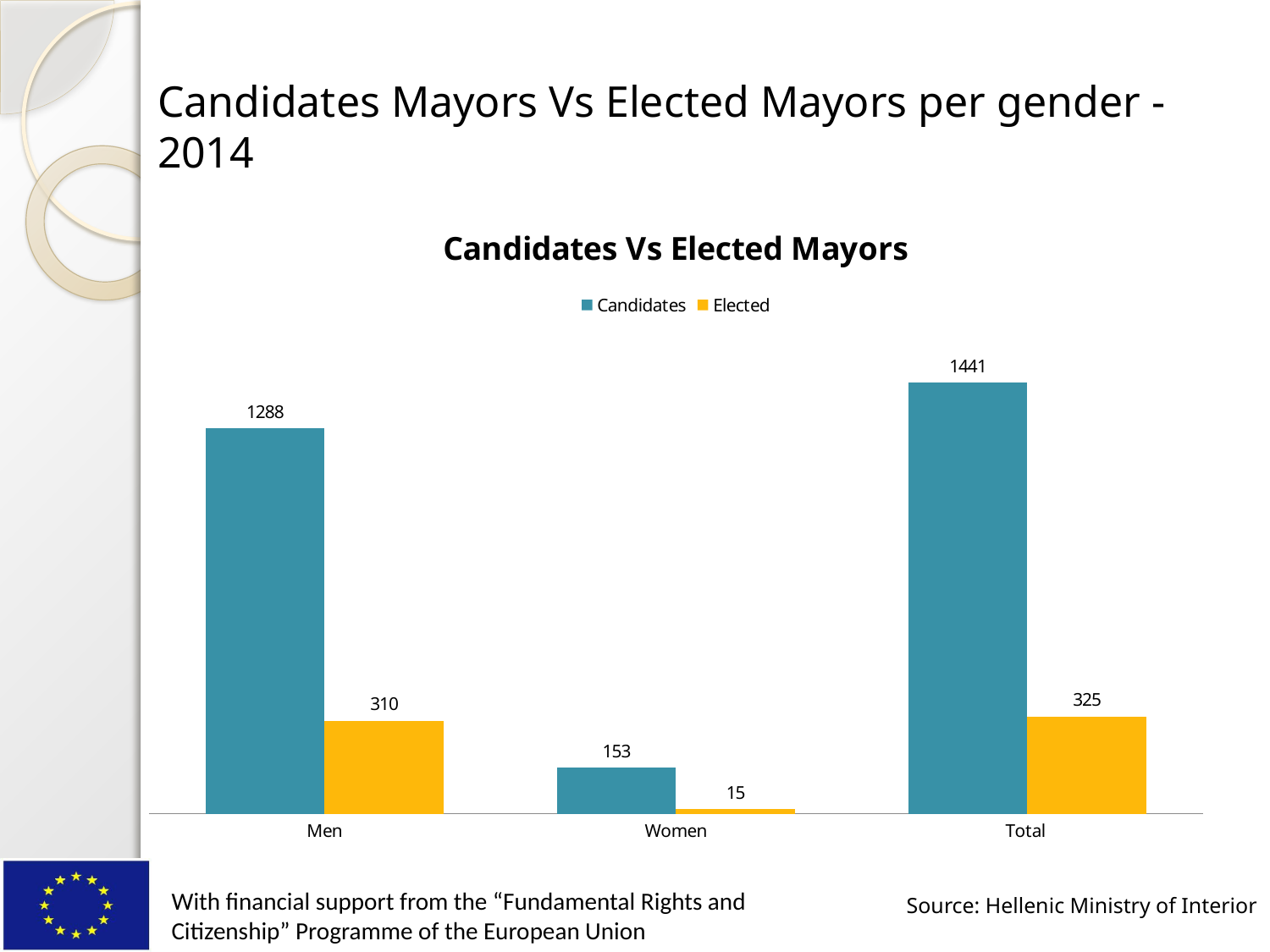
Which category has the highest Elected value? Total How many categories are shown on the x axis? 3 Which category has the lowest Candidates value? Women What is the Elected value for the Total category? 325 What is the number of Candidates for Men? 1288 How many series does the legend list? 2 What is the title of the chart? Candidates Vs Elected Mayors What is the number of Elected mayors for Women? 15 What is the difference between the Candidates values for Men and Women? 1135 What is the difference between Candidates and Elected for Men? 978 Which is larger, the Elected value for Men or the Candidates value for Women? Elected value for Men What kind of chart is shown on the slide? Bar chart